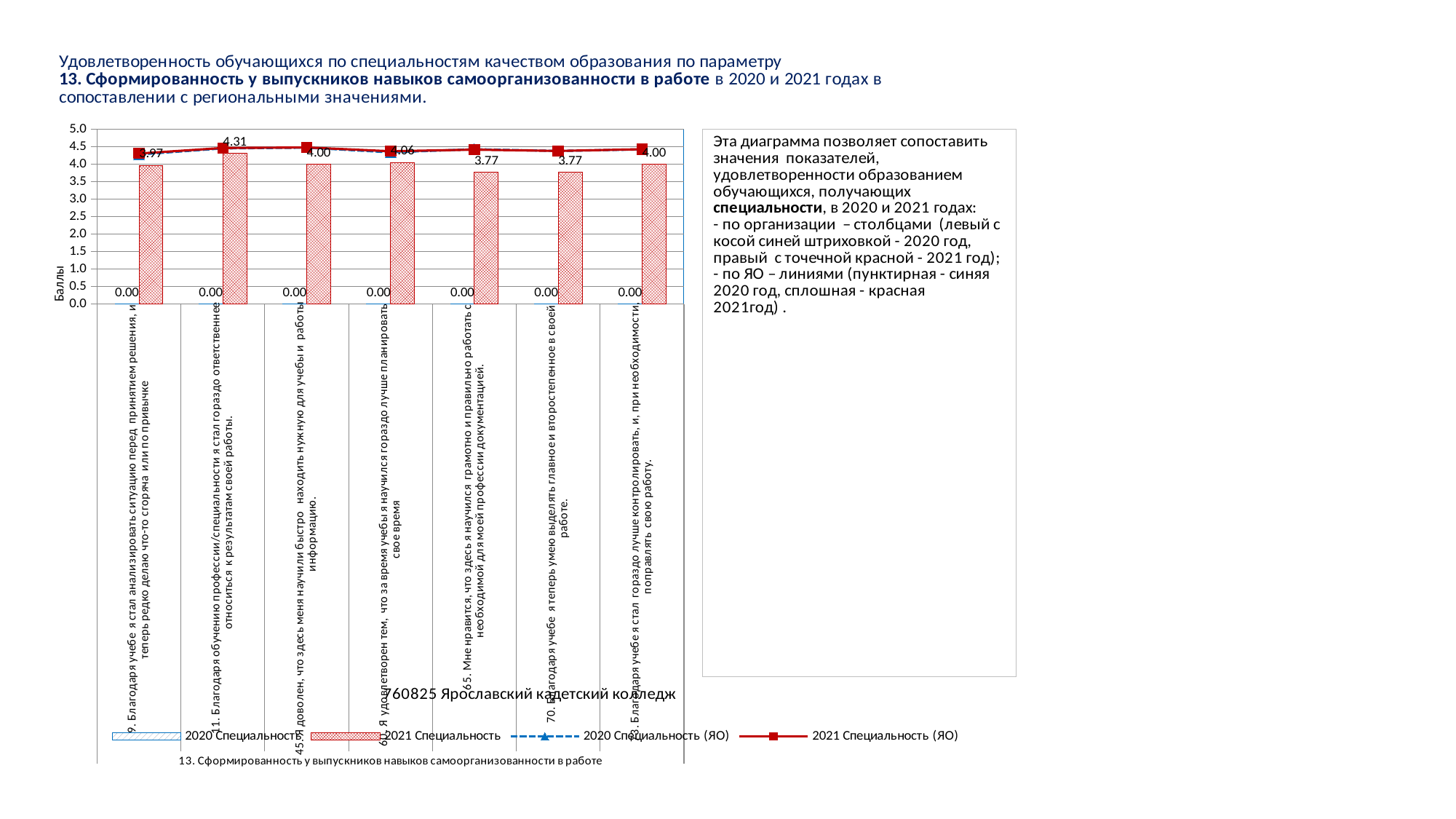
What is the 2021 Специальность value for category 65 (Мне нравится, что здесь я научился грамотно и правильно работать с необходимой для моей профессии документацией)? 3.77 Which category has the highest 2021 Специальность value? 11. Благодаря обучению профессии/специальности я стал гораздо ответственнее относиться к результатам своей работы. What is the difference between the 2021 Специальность values for category 11 and category 65? 0.54 What kind of chart is shown on the slide? Combined bar and line chart How many series does the chart legend list? 4 What is the label of the vertical axis of the chart? Баллы What is the maximum value shown on the vertical axis of the chart? 5.0 How many categories are shown on the x axis of the chart? 7 What is the 2021 Специальность value for category 11 (Благодаря обучению профессии/специальности я стал гораздо ответственнее относиться к результатам своей работы)? 4.31 What is the 2020 Специальность value for category 9? 0.00 Is the 2021 Специальность value for category 70 greater or less than 4.0? less